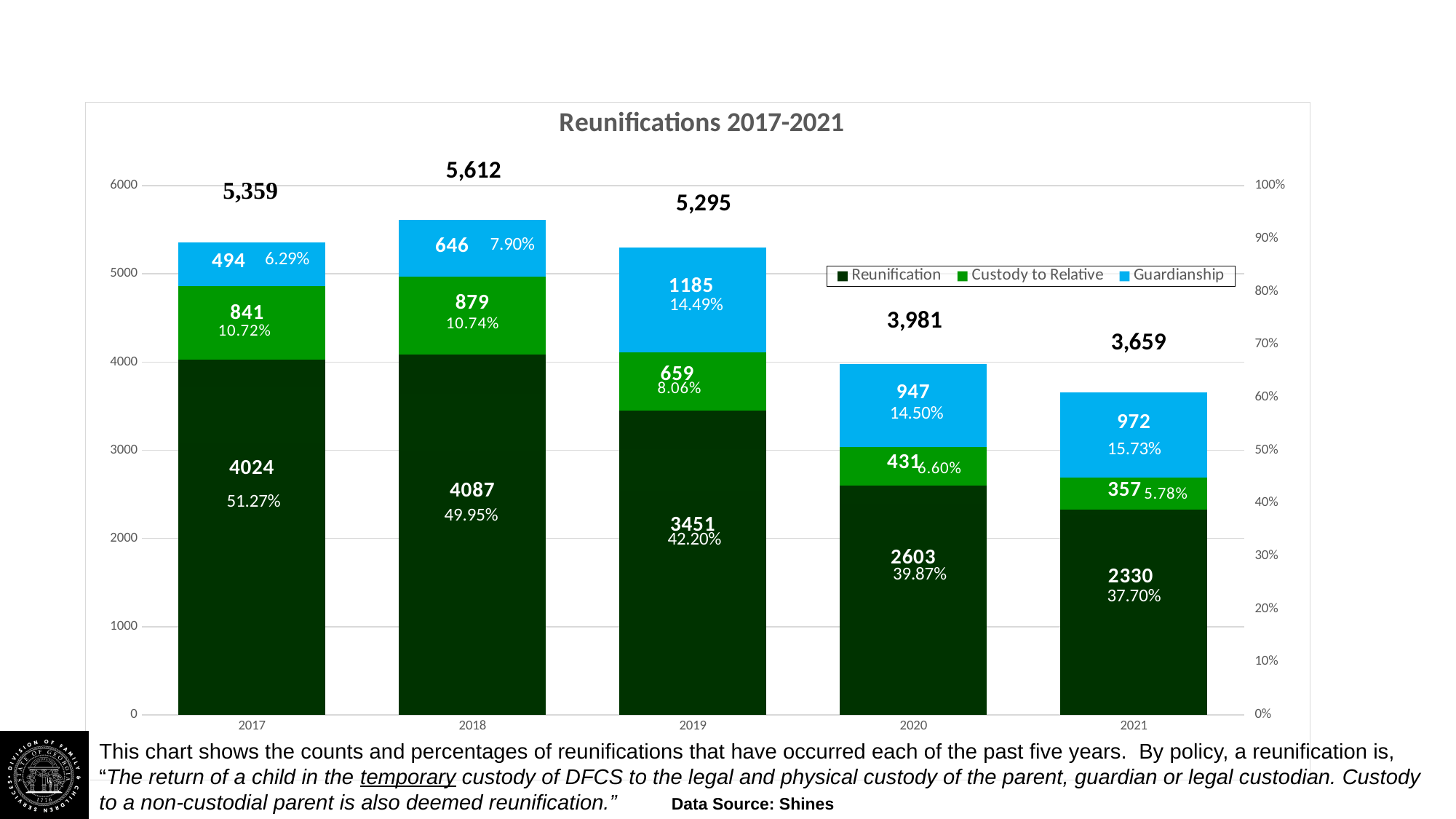
What percentage is shown for Reunification in 2017? 51.27% What is the total shown above the bar for 2020? 3,981 Which is larger, the Guardianship value for 2019 or for 2020? 2019 What is the difference between the Reunification values for 2018 and 2017? 63 Do the Reunification values rise or fall from 2018 to 2021? Fall Which year has the highest total shown above its bar? 2018 What is the Custody to Relative value for 2018? 879 What is the Guardianship value for 2021? 972 What is the Reunification value for 2019? 3451 Which year has the lowest total shown above its bar? 2021 What kind of chart is shown? Stacked bar chart How many series does the legend list? 3